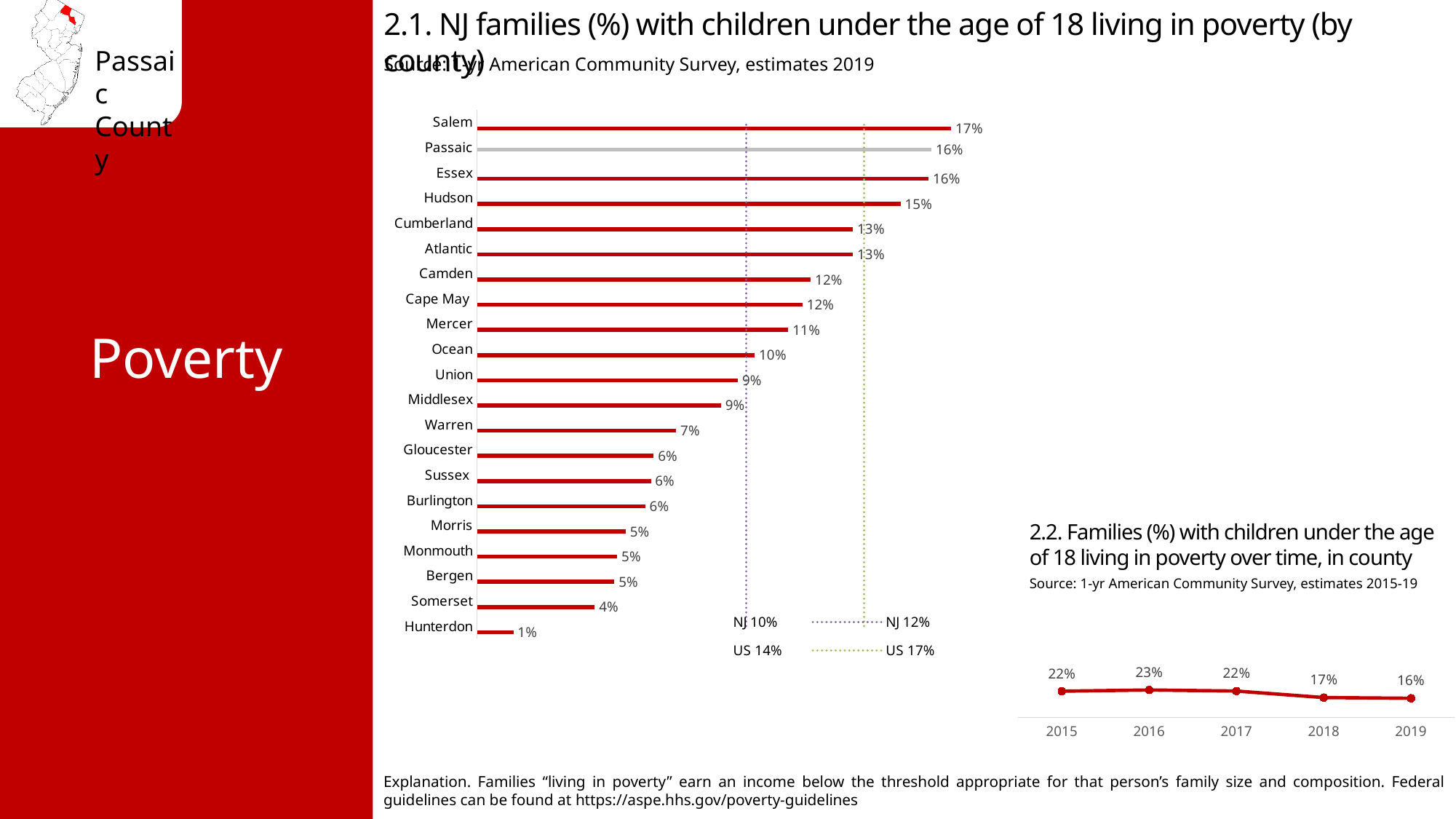
In chart 2.2 (families in poverty over time, in county), what is the value for 2016? 23% In chart 2.1 (by county), what is the value for Hudson? 15% What kind of chart is chart 2.1 (by county)? Bar chart In chart 2.1 (NJ families with children under 18 living in poverty by county), what is the value for Passaic? 16% In chart 2.1 (by county), which has a higher value, Mercer or Warren? Mercer In chart 2.1 (by county), what is the difference between the values for Salem and Somerset? 13% In chart 2.1 (by county), which county has the highest percentage of families with children living in poverty? Salem In chart 2.1 (by county), which county has the lowest percentage of families with children living in poverty? Hunterdon In chart 2.2 (over time, in county), what is the difference between the values for 2016 and 2019? 7% In chart 2.1 (by county), how many counties are shown? 21 In chart 2.2 (over time, in county), do the values rise or fall from 2017 to 2019? Fall